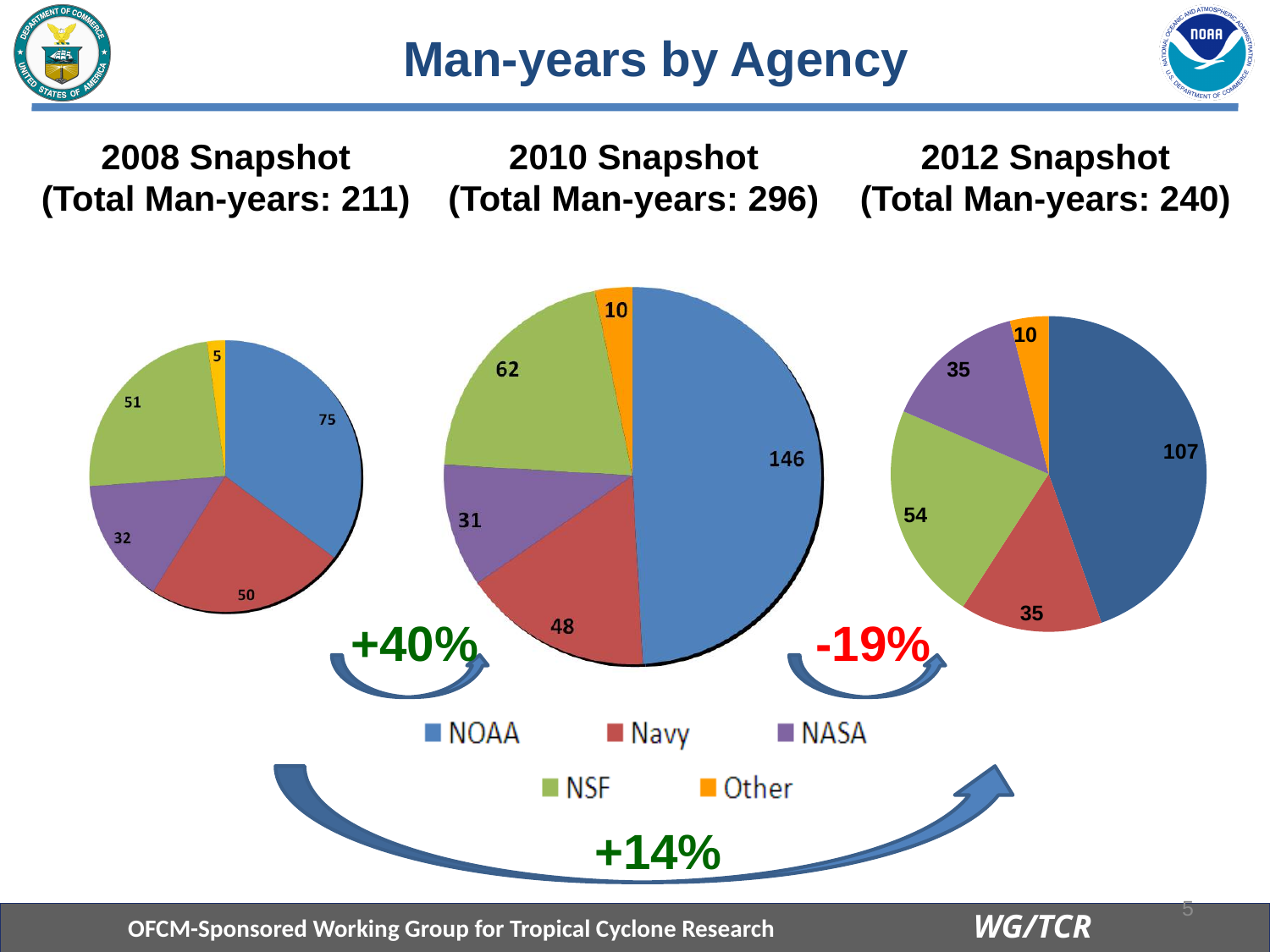
What is the total man-years stated in the title of the 2010 Snapshot? 296 In the 2010 Snapshot pie chart, how many man-years are attributed to NSF? 62 What is the difference between NOAA man-years in the 2010 Snapshot and NOAA man-years in the 2012 Snapshot? 39 In the 2008 Snapshot pie chart, which category has the smallest slice? Other In the 2008 Snapshot pie chart, how many man-years are attributed to NOAA? 75 How many slices does the 2010 Snapshot pie chart have? 5 How many entries does the shared legend list? 5 In the 2012 Snapshot pie chart, what is the difference between the NSF and Navy values? 19 In the 2008 Snapshot pie chart, which is larger, the Navy slice or the NASA slice? Navy In the 2010 Snapshot pie chart, which agency has the largest slice? NOAA In the 2012 Snapshot pie chart, how many man-years are attributed to NASA? 35 What type of chart is used for the 2012 Snapshot? Pie chart